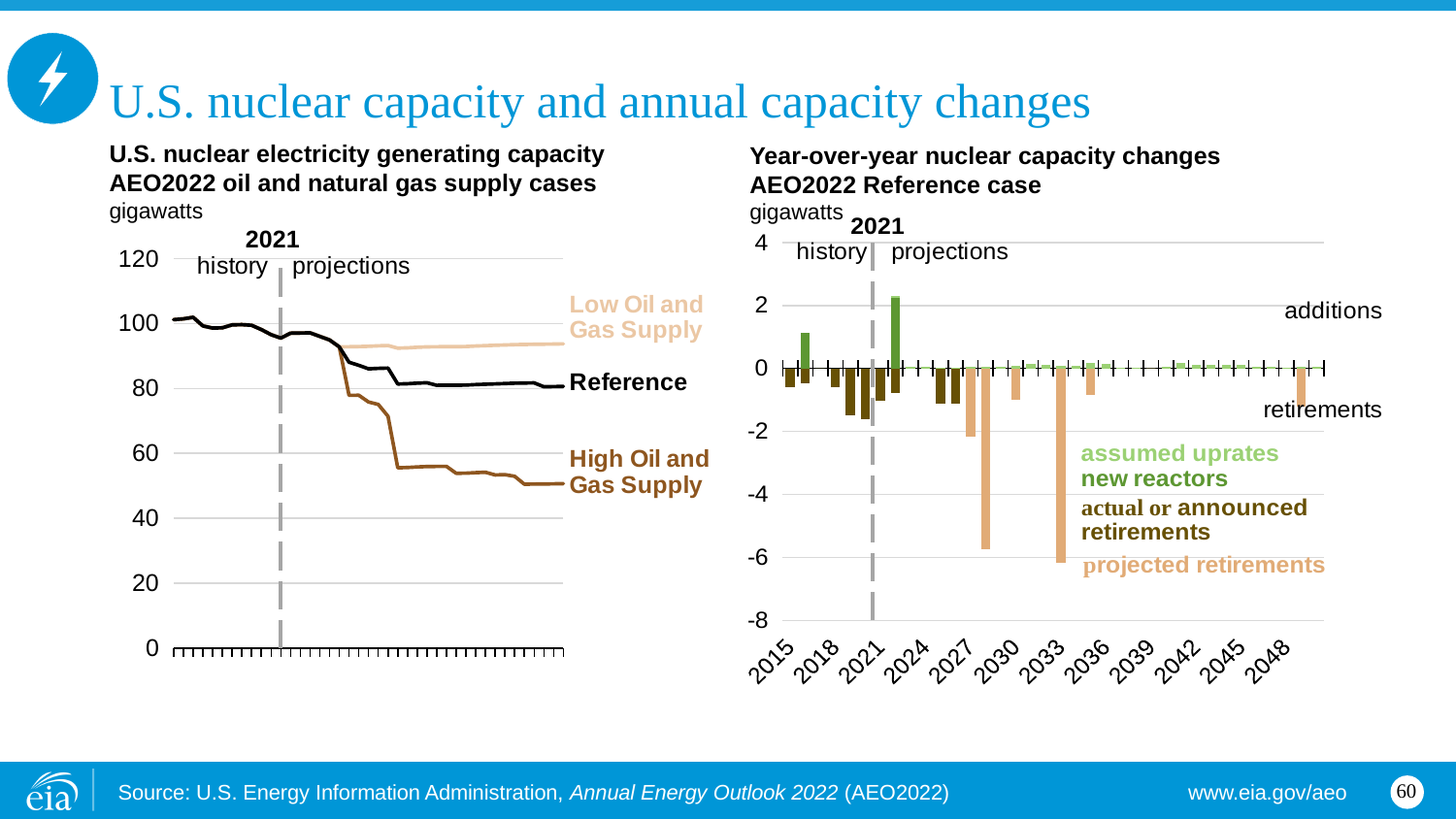
On the left chart, does the Reference case capacity rise or fall over the projection period? fall On the left chart, which case ends the projection period with higher capacity: Reference or High Oil and Gas Supply? Reference How many categories does the legend of the right chart, 'Year-over-year nuclear capacity changes', list? 4 On the right chart, is the largest projected retirement bar (around 2033) greater or less than -4 gigawatts? less On the left chart, is the High Oil and Gas Supply value at the end of the projection period greater or less than 60 gigawatts? less What type of chart is the right chart, 'Year-over-year nuclear capacity changes'? bar chart On the left chart, is the Low Oil and Gas Supply value at the end of the projection period greater or less than 80 gigawatts? greater What unit is used on the y-axis of both charts? gigawatts How many series are plotted on the left chart, 'U.S. nuclear electricity generating capacity'? 3 What type of chart is the left chart, 'U.S. nuclear electricity generating capacity'? line chart